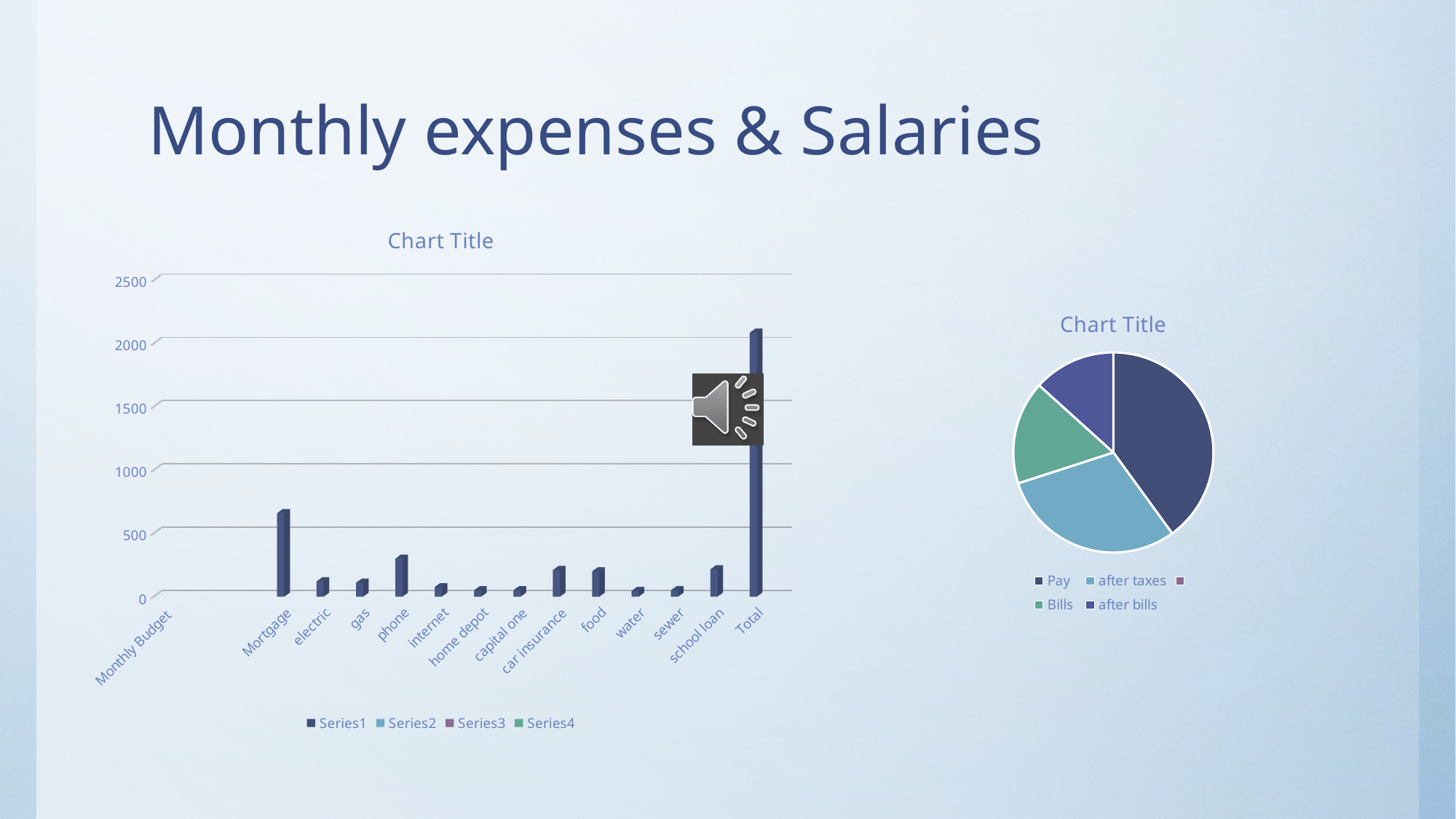
How many categories are shown on the x axis of the bar chart on the left? 14 How many series does the legend of the bar chart on the left list? 4 What kind of chart is the chart on the left of the slide? bar chart In the pie chart on the right, which is larger, the slice for after taxes or the slice for Bills? after taxes In the bar chart on the left, is the value for phone greater or less than 500? less In the bar chart on the left, which category has the highest value? Total In the pie chart on the right, which slice is the largest? Pay What is the title of the bar chart on the left? Chart Title What kind of chart is the chart on the right of the slide? pie chart In the bar chart on the left, which is larger, the value for Mortgage or the value for phone? Mortgage In the bar chart on the left, is the value for Total greater or less than 2000? greater In the bar chart on the left, is the value for Mortgage greater or less than 500? greater